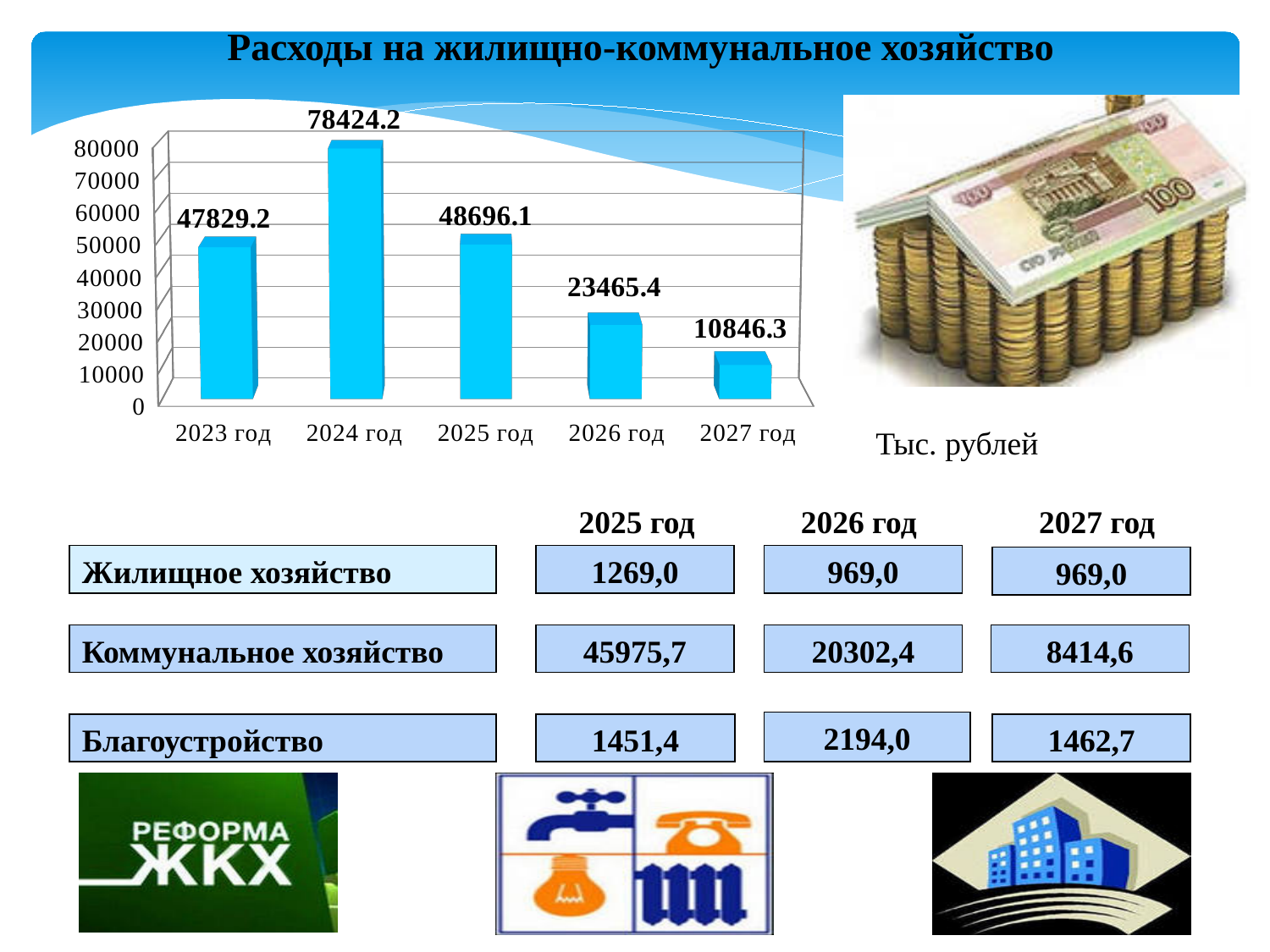
Which year has the highest value in the bar chart? 2024 год Which year has the lowest value in the bar chart? 2027 год Do the values rise or fall from 2024 год to 2027 год? fall What is the value for 2023 год in the bar chart? 47829.2 How many years are shown on the x axis of the bar chart? 5 What is the difference between the values for 2026 год and 2027 год? 12619.1 What is the value for 2027 год in the bar chart? 10846.3 What is the difference between the values for 2024 год and 2023 год? 30595.0 What kind of chart is shown on the slide? bar chart Which is larger, the value for 2025 год or the value for 2026 год? 2025 год What is the value for 2024 год in the bar chart? 78424.2 Is the value for 2026 год greater or less than 30000? less